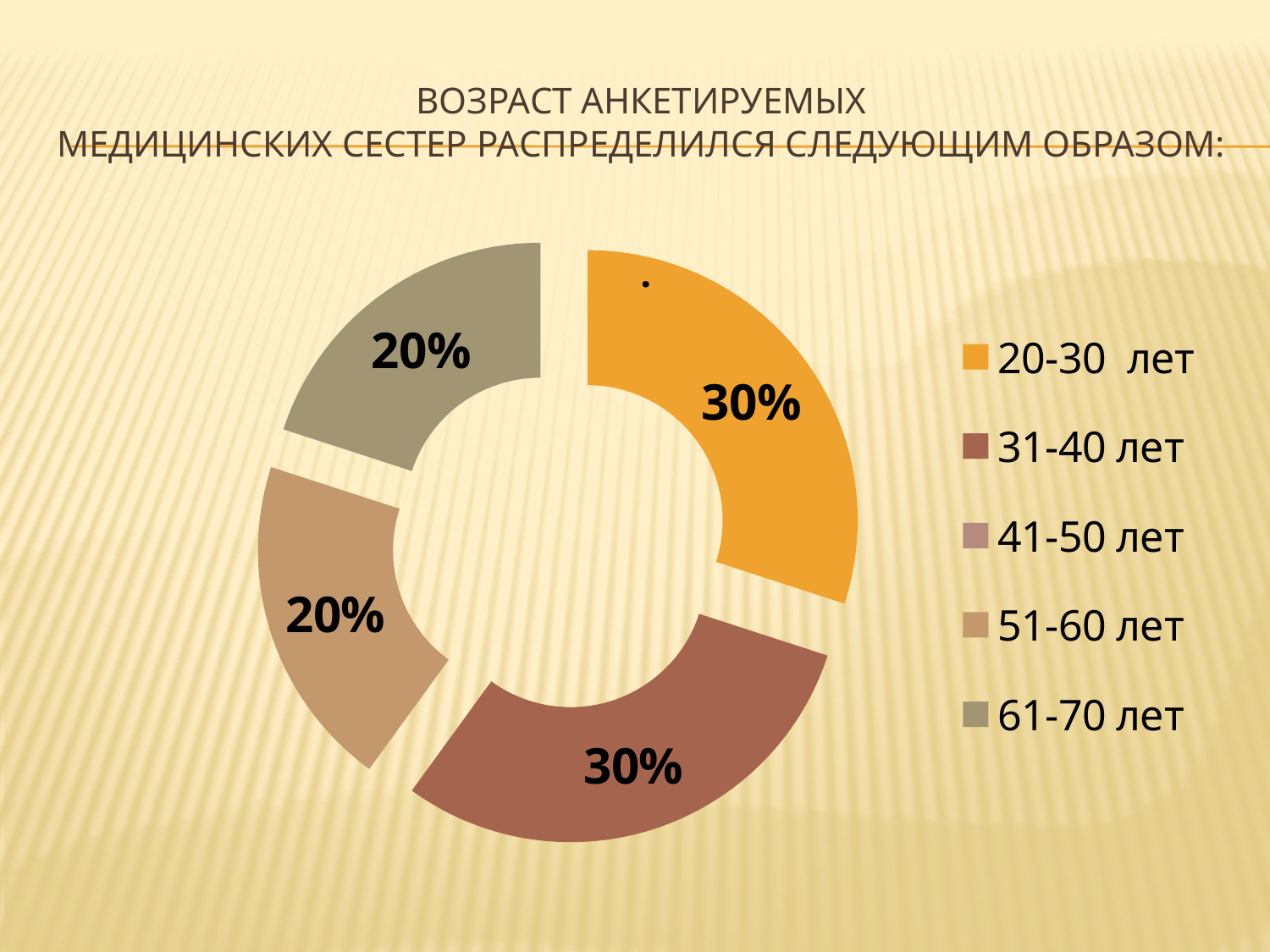
What share of the surveyed nurses are aged 31-40 лет? 30% What share of the surveyed nurses are aged 51-60 лет? 20% How many categories does the legend list? 5 How many slices are visible in the chart? 4 What is the combined share of the 20-30 лет and 31-40 лет groups? 60% What share of the surveyed nurses are aged 61-70 лет? 20% Which legend category has no visible slice in the chart? 41-50 лет What colour is the slice for 20-30 лет? Orange Which is larger, the share for 20-30 лет or the share for 51-60 лет? 20-30 лет What share of the surveyed nurses are aged 20-30 лет? 30% What is the difference between the share for 31-40 лет and the share for 61-70 лет? 10% What kind of chart is shown on the slide? Doughnut (pie) chart